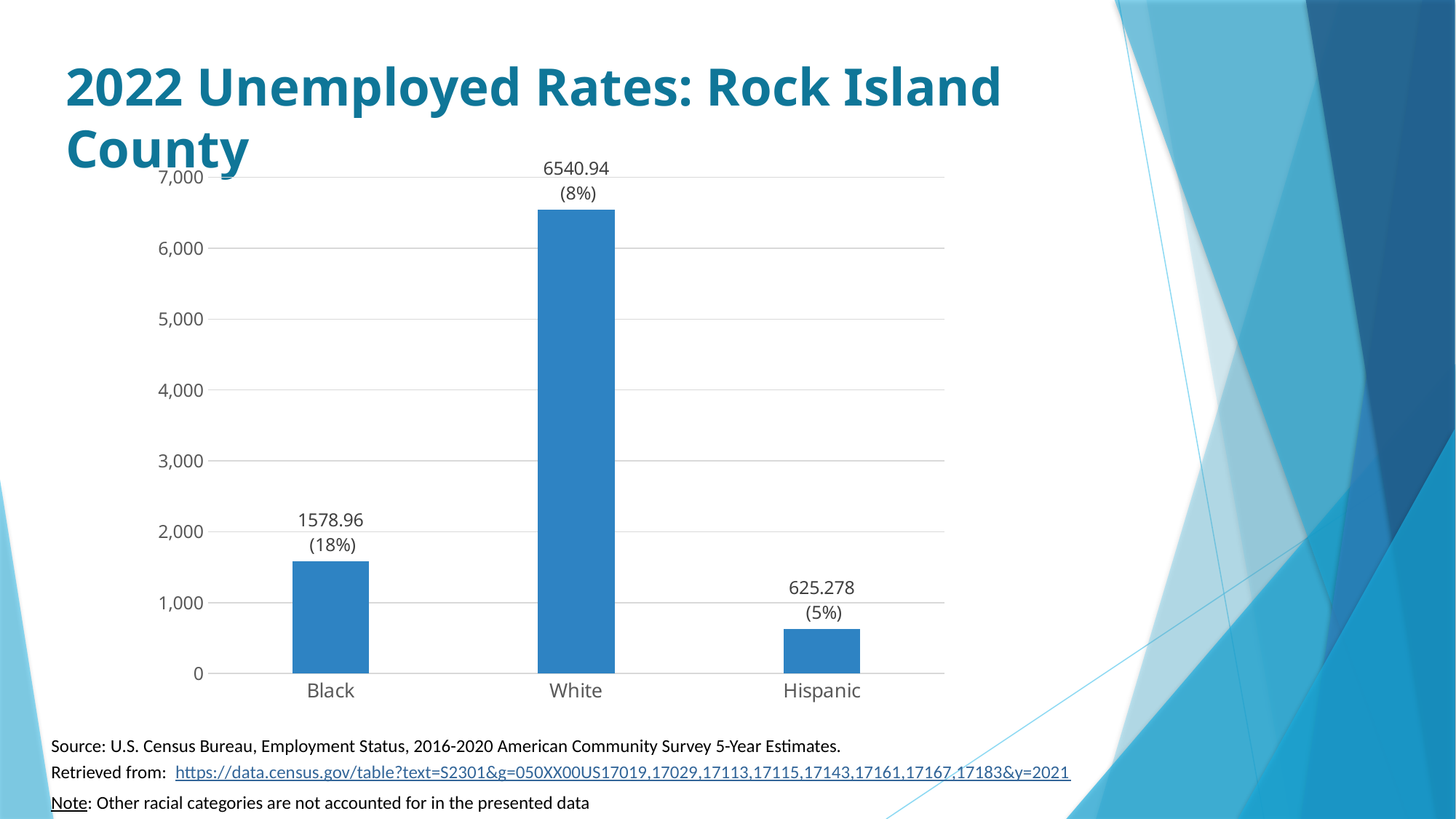
What kind of chart is shown on the slide? Bar chart Which category has the lowest bar? Hispanic What percentage is shown in parentheses for Hispanic? 5% What is the difference between the values for Black and Hispanic? 953.682 What is the value shown for White? 6540.94 What is the difference between the values for White and Black? 4961.98 How many categories are shown on the x axis? 3 What is the value shown for Hispanic? 625.278 Which category has the highest bar? White Which is larger, the value for Black or the value for Hispanic? Black What percentage is shown in parentheses for Black? 18% What is the value shown for Black? 1578.96